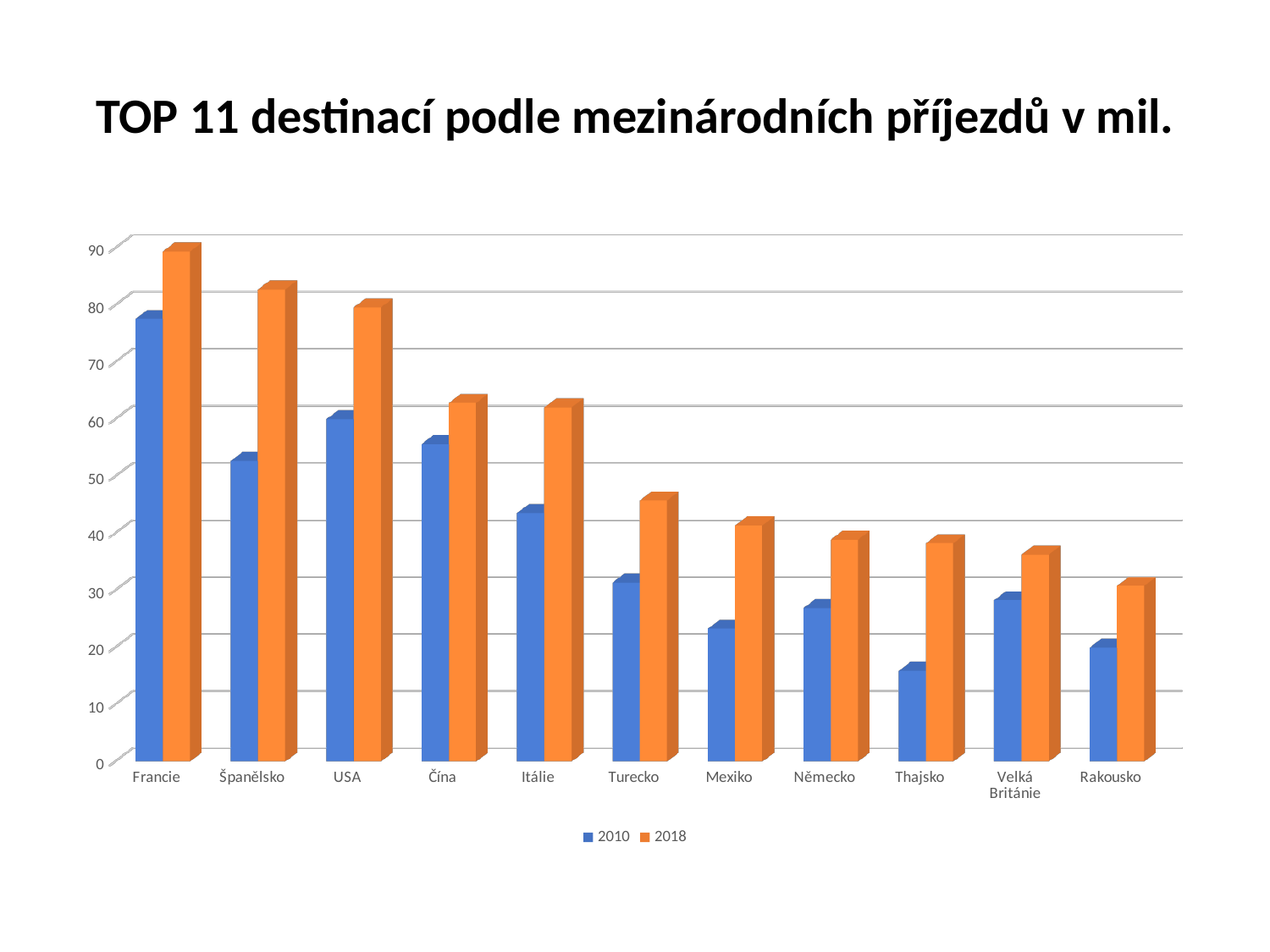
Is the 2010 value for Thajsko greater or less than 20? less Is the 2018 value for Francie greater or less than 80? greater How many destinations (categories) are shown on the x axis? 11 How many series does the legend list? 2 Which destination has the highest value for 2018? Francie Which destination has the lowest value for 2010? Thajsko What kind of chart is shown on the slide? bar chart What is the title of the chart? TOP 11 destinací podle mezinárodních příjezdů v mil. Which is larger, the 2010 value for Čína or the 2010 value for Itálie? Čína Is the 2018 value for Rakousko greater or less than 40? less Do the 2018 values generally rise or fall moving from left to right along the x axis? fall